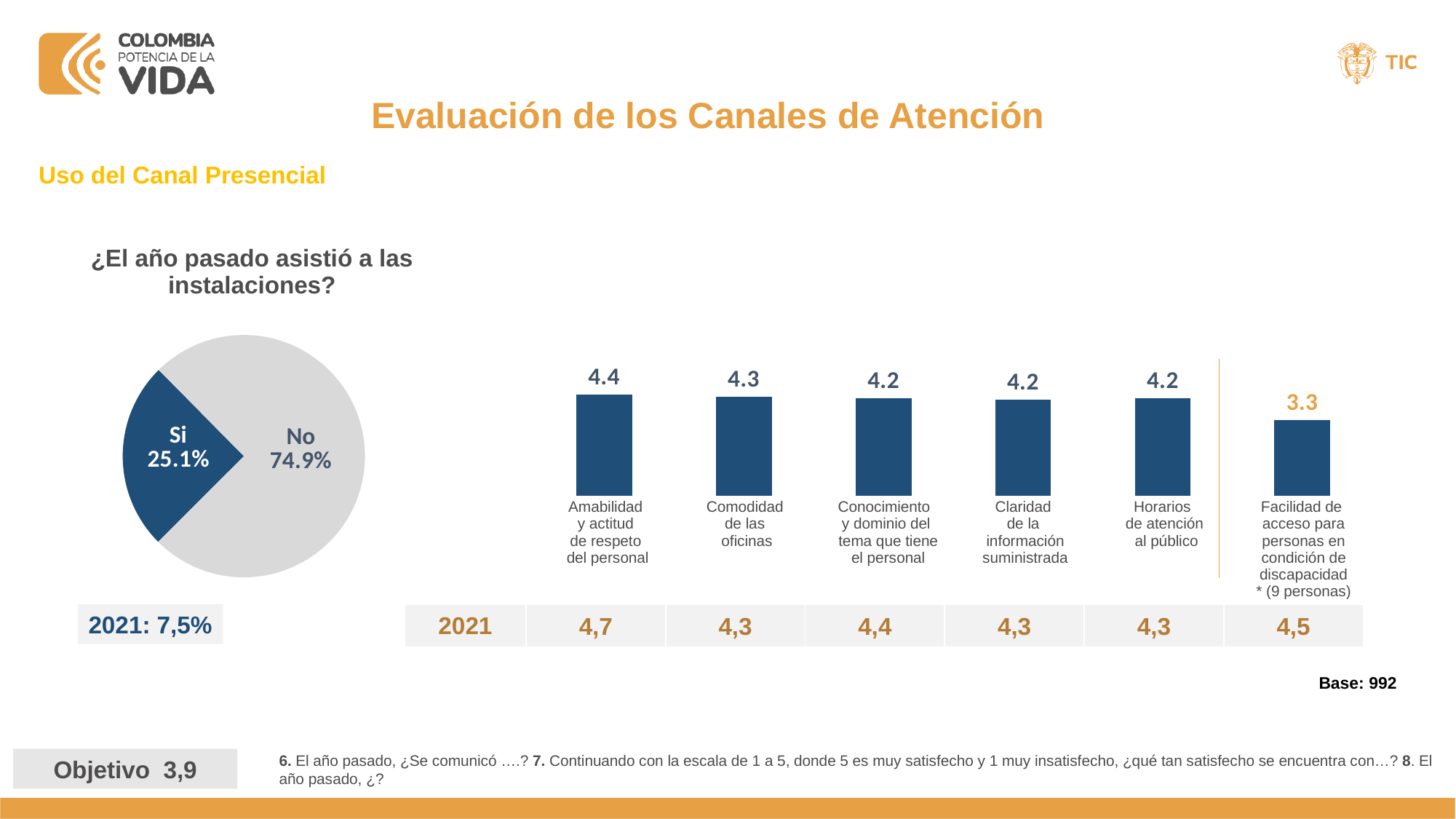
In the pie chart '¿El año pasado asistió a las instalaciones?', how many slices are there? 2 In the bar chart on the right, which category has the lowest value? Facilidad de acceso para personas en condición de discapacidad In the bar chart on the right, how many categories are plotted? 6 In the bar chart on the right, what is the difference between the values for 'Amabilidad y actitud de respeto del personal' and 'Facilidad de acceso para personas en condición de discapacidad'? 1.1 What kind of chart is the one on the left of the slide, titled '¿El año pasado asistió a las instalaciones?'? Pie chart In the bar chart on the right, what is the value for 'Facilidad de acceso para personas en condición de discapacidad'? 3.3 In the bar chart on the right, what is the value for 'Amabilidad y actitud de respeto del personal'? 4.4 What kind of chart is the one on the right of the slide showing the satisfaction scores? Bar chart In the pie chart '¿El año pasado asistió a las instalaciones?', which slice is larger, 'Si' or 'No'? No In the pie chart '¿El año pasado asistió a las instalaciones?', what percentage answered 'Si'? 25.1% In the bar chart on the right, which category has the highest value? Amabilidad y actitud de respeto del personal In the pie chart '¿El año pasado asistió a las instalaciones?', what percentage answered 'No'? 74.9%